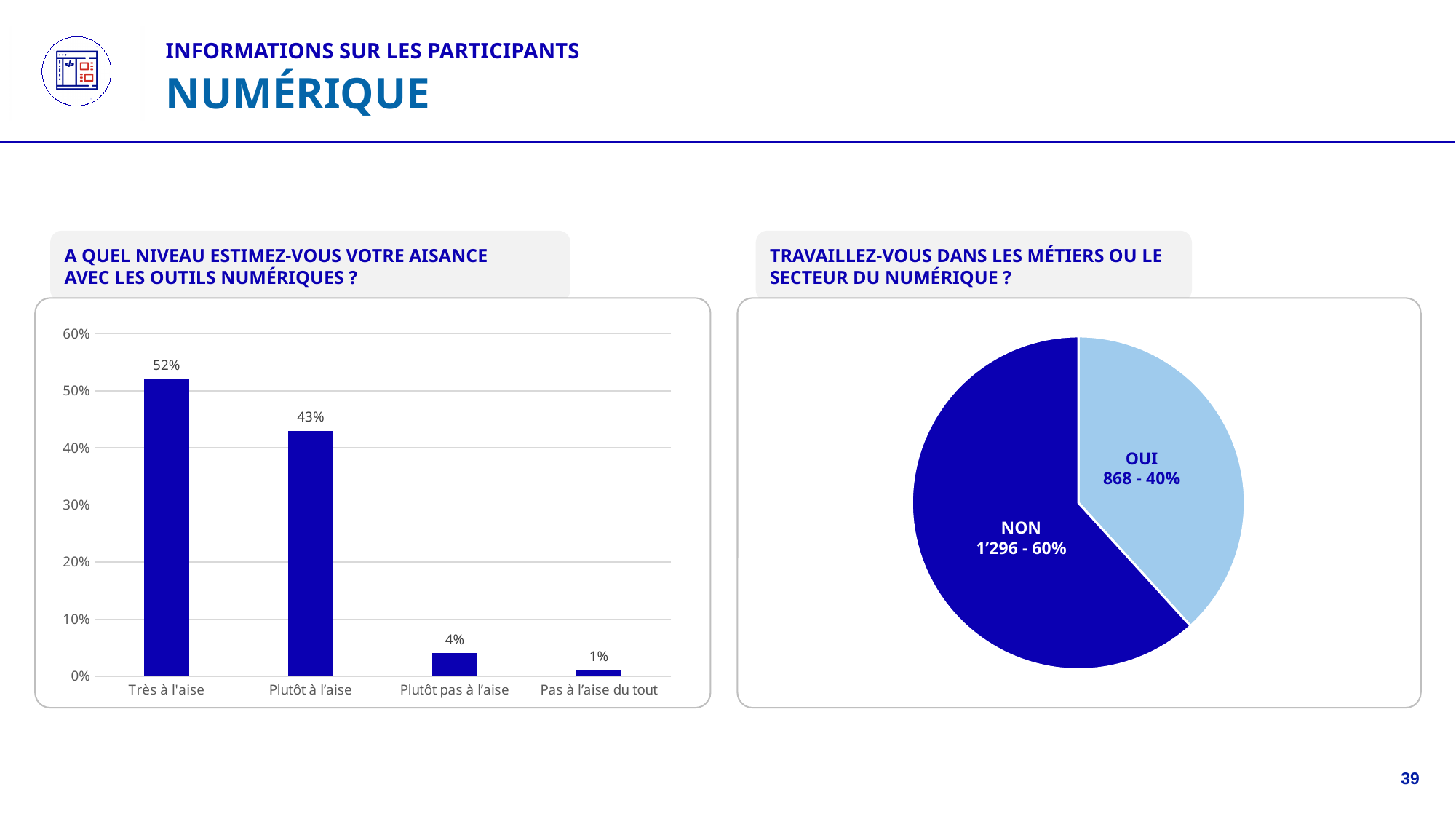
In the left chart (A quel niveau estimez-vous votre aisance avec les outils numériques ?), which category has the highest value? Très à l'aise What kind of chart is the left chart (A quel niveau estimez-vous votre aisance avec les outils numériques ?)? Bar chart In the left chart (A quel niveau estimez-vous votre aisance avec les outils numériques ?), how many categories are shown on the x axis? 4 In the right chart (Travaillez-vous dans les métiers ou le secteur du numérique ?), how many participants answered "OUI"? 868 In the left chart (A quel niveau estimez-vous votre aisance avec les outils numériques ?), which category has the lowest value? Pas à l'aise du tout What kind of chart is the right chart (Travaillez-vous dans les métiers ou le secteur du numérique ?)? Pie chart In the left chart (A quel niveau estimez-vous votre aisance avec les outils numériques ?), which is larger: "Plutôt à l'aise" or "Plutôt pas à l'aise"? Plutôt à l'aise In the left chart (A quel niveau estimez-vous votre aisance avec les outils numériques ?), what is the value for "Très à l'aise"? 52% In the left chart (A quel niveau estimez-vous votre aisance avec les outils numériques ?), what is the value for "Plutôt pas à l'aise"? 4% In the left chart (A quel niveau estimez-vous votre aisance avec les outils numériques ?), what is the difference between "Très à l'aise" and "Plutôt à l'aise"? 9% In the right chart (Travaillez-vous dans les métiers ou le secteur du numérique ?), what share of the pie is "NON"? 60% In the left chart (A quel niveau estimez-vous votre aisance avec les outils numériques ?), do the values rise or fall from left to right along the x axis? Fall